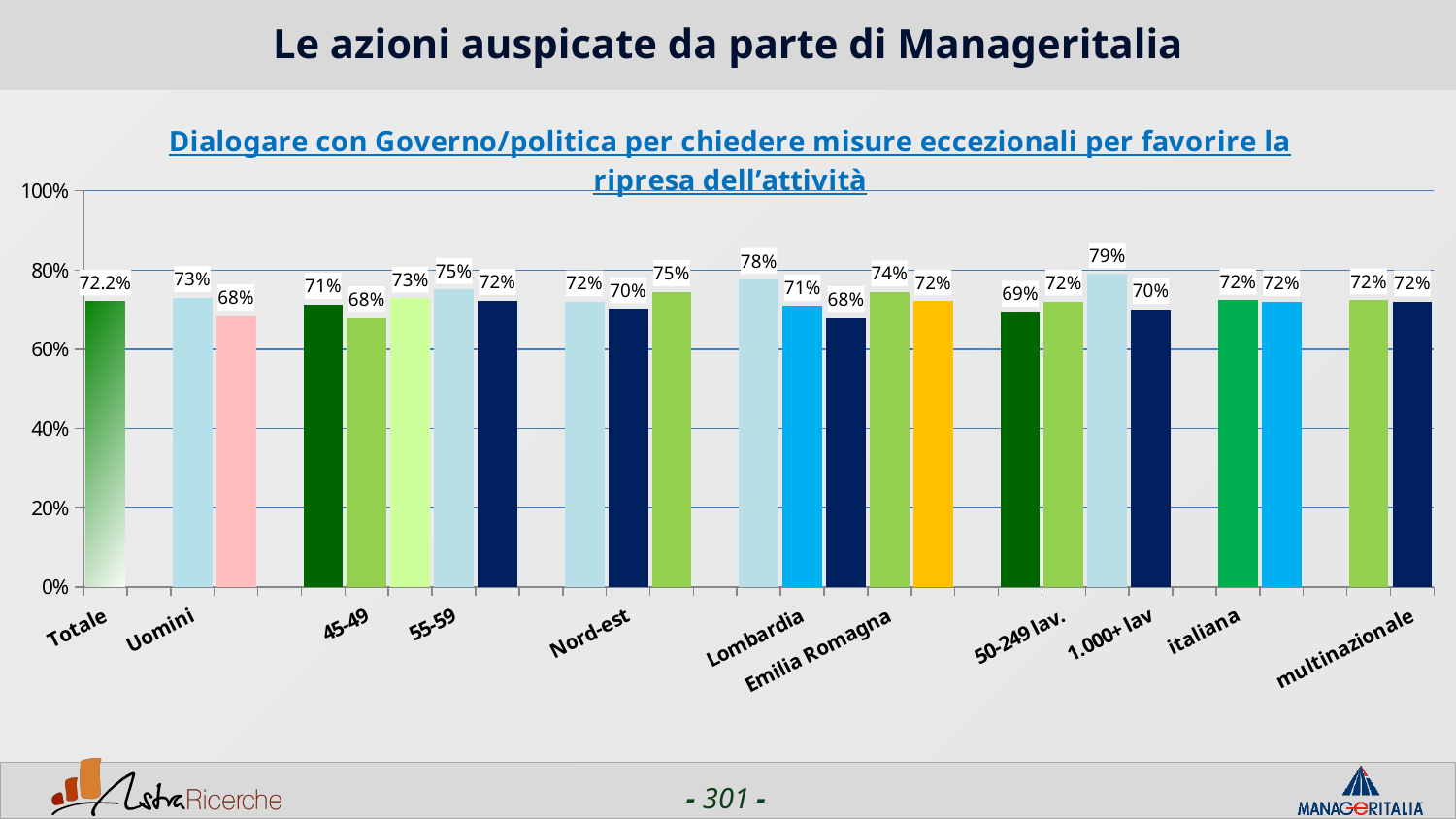
What is the difference between the values for Emilia Romagna and Lombardia? 3 percentage points Is the value for Totale greater or less than 60%? greater What is the value for Totale? 72.2% What is the value for Uomini? 73% What kind of chart is shown on the slide? Bar chart What is the value for Emilia Romagna? 74% What is the value for Lombardia? 71% Which is larger, the value for Lombardia or the value for Emilia Romagna? Emilia Romagna What is the value for multinazionale? 72% What is the value for Nord-est? 70% What is the value for the 55-59 category? 75% What is the title of the chart? Dialogare con Governo/politica per chiedere misure eccezionali per favorire la ripresa dell'attività